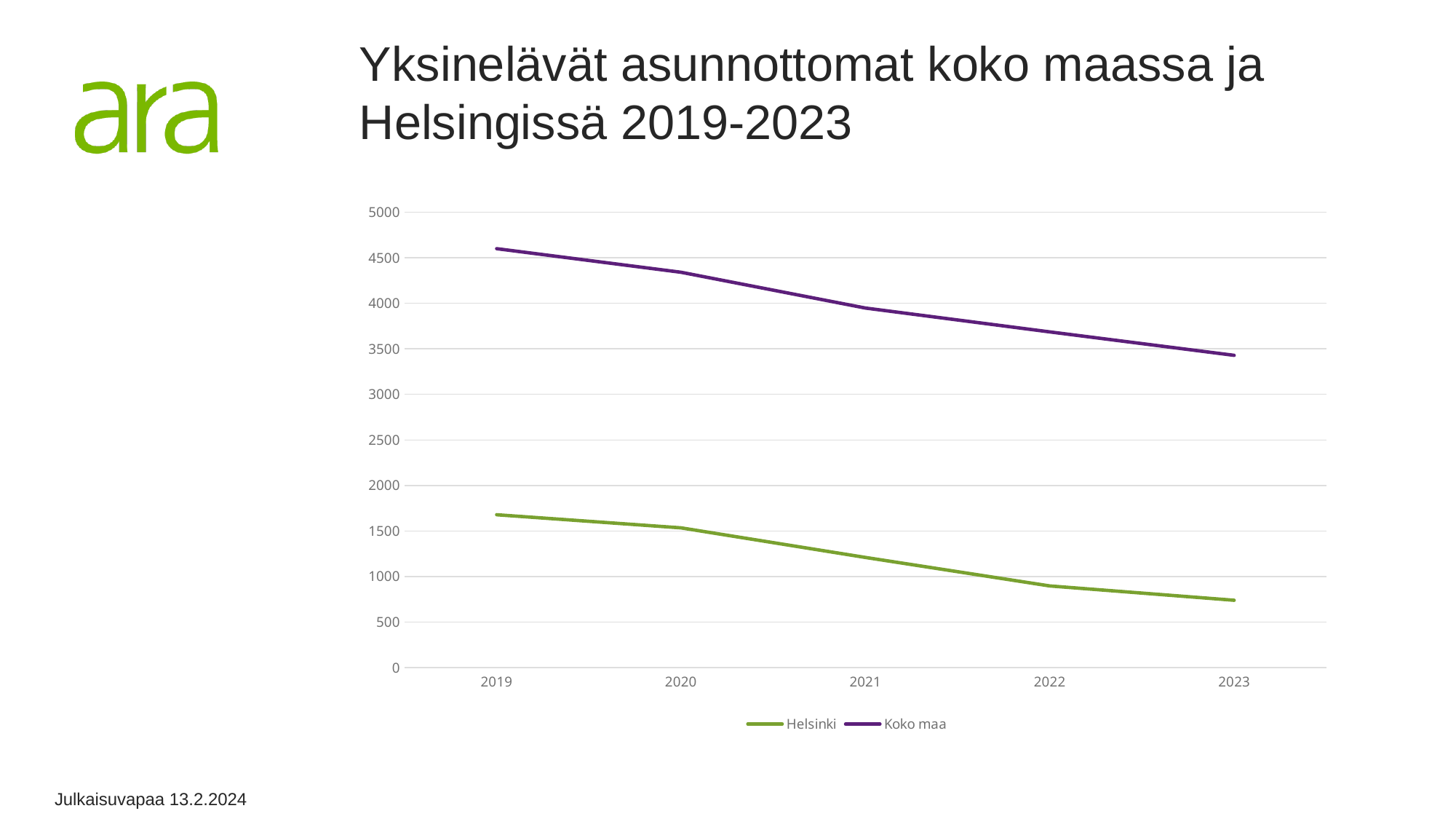
Do the values for Koko maa rise or fall from 2019 to 2023? fall Which year has the lowest value for Koko maa? 2023 What kind of chart is shown on the slide? line chart Do the values for Helsinki rise or fall from 2019 to 2023? fall How many series does the legend list? 2 Is the value for Koko maa in 2023 greater or less than 3500? less How many years are shown on the x axis? 5 Is the value for Helsinki in 2019 greater or less than 1500? greater Is the value for Helsinki in 2022 greater or less than 1000? less Which year has the highest value for Helsinki? 2019 Which series is drawn in green? Helsinki